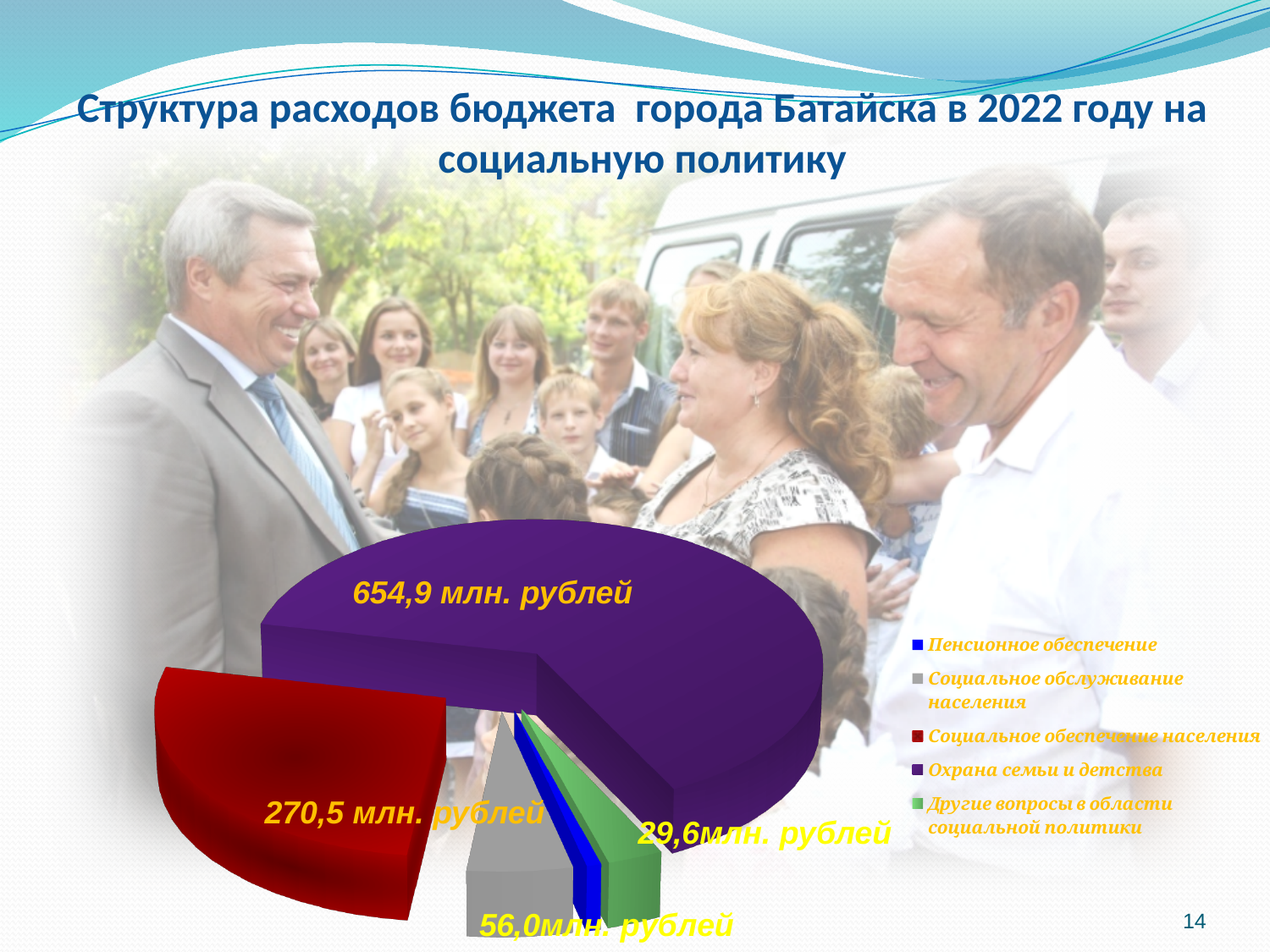
What kind of chart is shown on the slide? Pie chart What is the value shown for Другие вопросы в области социальной политики? 29,6 млн. рублей What colour is the slice for Охрана семьи и детства? Purple What is the difference between the values for Социальное обслуживание населения and Другие вопросы в области социальной политики? 26,4 млн. рублей Which category has the smallest slice of the pie? Пенсионное обеспечение Which is larger: Социальное обеспечение населения or Социальное обслуживание населения? Социальное обеспечение населения What is the value shown for Социальное обслуживание населения? 56,0 млн. рублей What is the value shown for Охрана семьи и детства? 654,9 млн. рублей How many categories does the legend of the pie chart list? 5 What is the difference between the values for Охрана семьи и детства and Социальное обеспечение населения? 384,4 млн. рублей Which category has the largest slice of the pie? Охрана семьи и детства What is the value shown for Социальное обеспечение населения? 270,5 млн. рублей